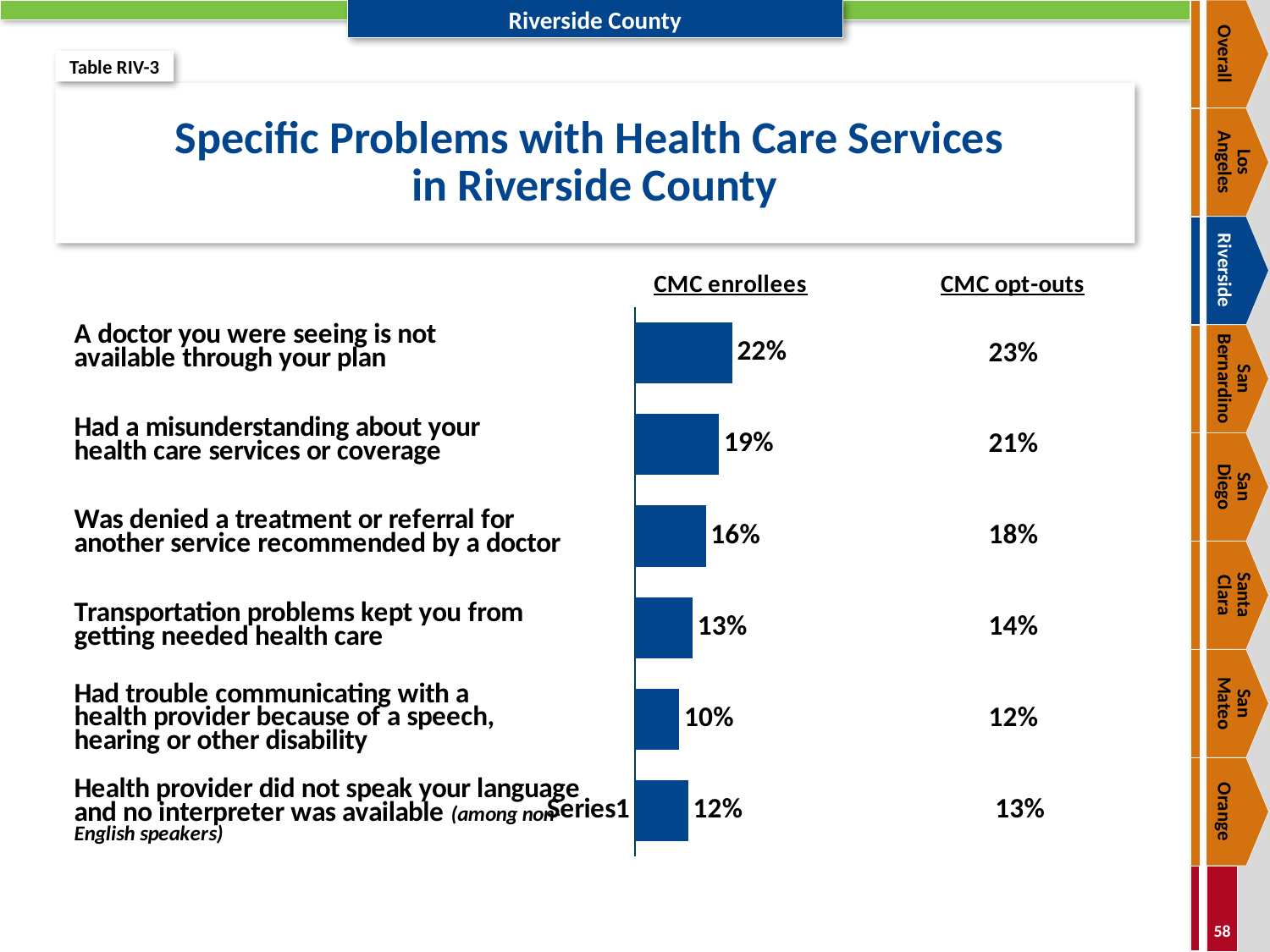
What is the CMC enrollees value for "A doctor you were seeing is not available through your plan"? 22% What is the difference between the CMC enrollees value (16%) and the CMC opt-outs value (18%) for "Was denied a treatment or referral for another service recommended by a doctor"? 2% What is the CMC enrollees value for "Transportation problems kept you from getting needed health care"? 13% How many problem categories are plotted in the bar chart? 6 Which problem has the highest CMC enrollees percentage in the bar chart? A doctor you were seeing is not available through your plan What type of chart is used to show the CMC enrollees values? Bar chart What colour are the bars in the chart? Blue Which has a larger CMC enrollees value: "Transportation problems kept you from getting needed health care" or "Health provider did not speak your language and no interpreter was available"? Transportation problems kept you from getting needed health care What is the CMC enrollees value for "Was denied a treatment or referral for another service recommended by a doctor"? 16% What is the difference between the CMC enrollees values for "A doctor you were seeing is not available through your plan" and "Had a misunderstanding about your health care services or coverage"? 3% Which problem has the lowest CMC enrollees percentage in the bar chart? Had trouble communicating with a health provider because of a speech, hearing or other disability What is the title of the slide containing the bar chart? Specific Problems with Health Care Services in Riverside County